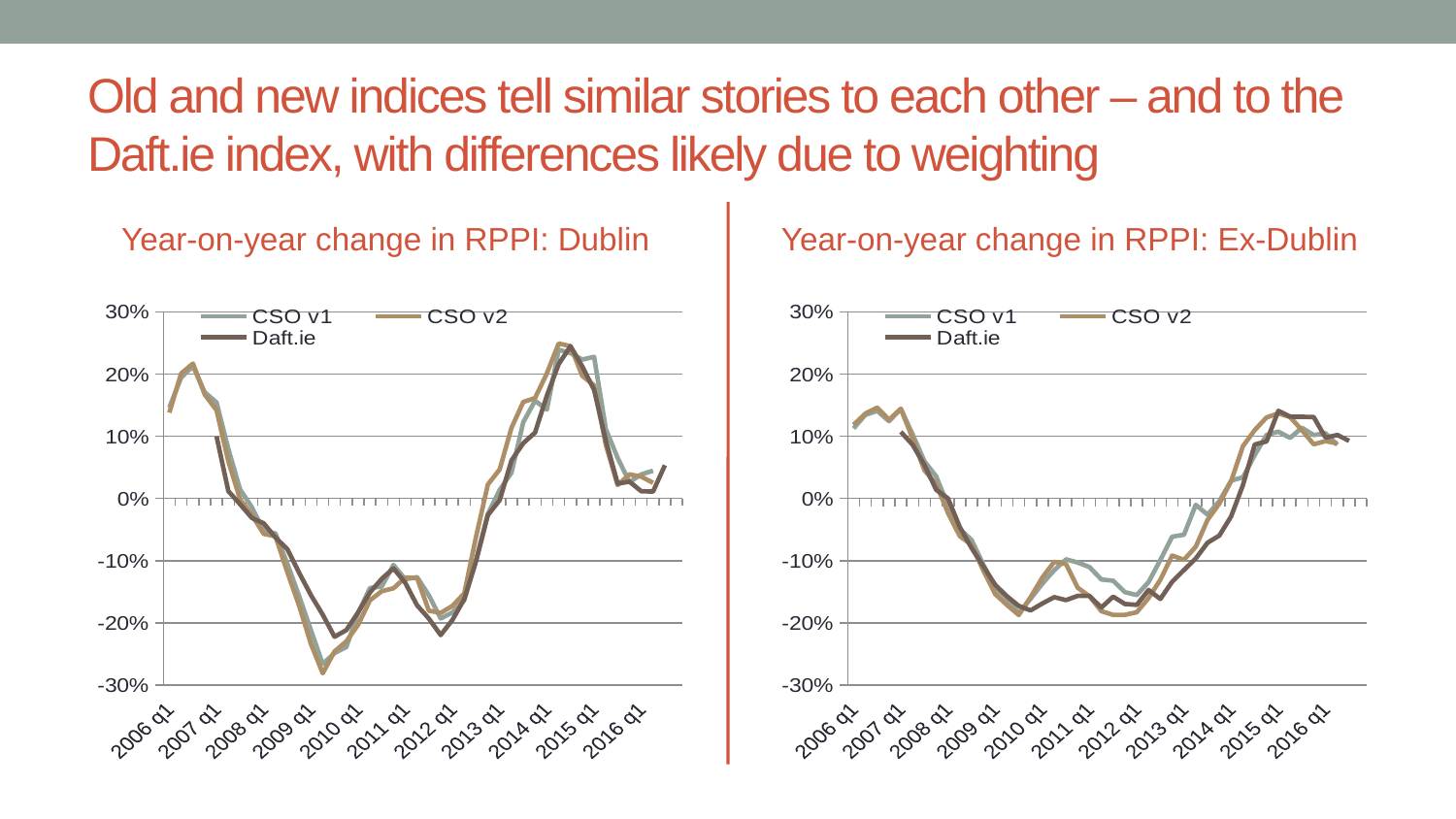
In the 'Year-on-year change in RPPI: Dublin' chart, is the peak value of CSO v2 around 2014 q4 greater or less than 20%? greater What kind of chart is the 'Year-on-year change in RPPI: Dublin' chart? line chart Which chart shows the higher peak year-on-year change around 2014-2015: the Dublin chart or the Ex-Dublin chart? Dublin In the 'Year-on-year change in RPPI: Dublin' chart, is the lowest value of CSO v2 around 2009 q1 greater or less than -20%? less Which series are listed in the legend of the 'Year-on-year change in RPPI: Dublin' chart? CSO v1, CSO v2, Daft.ie In the 'Year-on-year change in RPPI: Ex-Dublin' chart, do the series rise or fall between 2012 q1 and 2014 q1? rise How many series does the legend of the 'Year-on-year change in RPPI: Ex-Dublin' chart list? 3 What is the title of the chart on the right of the slide? Year-on-year change in RPPI: Ex-Dublin In the 'Year-on-year change in RPPI: Dublin' chart, do the series rise or fall between 2007 q1 and 2009 q1? fall How many year labels are shown on the x axis of the 'Year-on-year change in RPPI: Dublin' chart? 11 In the 'Year-on-year change in RPPI: Ex-Dublin' chart, is the peak value of Daft.ie around 2015 q1 greater or less than 20%? less